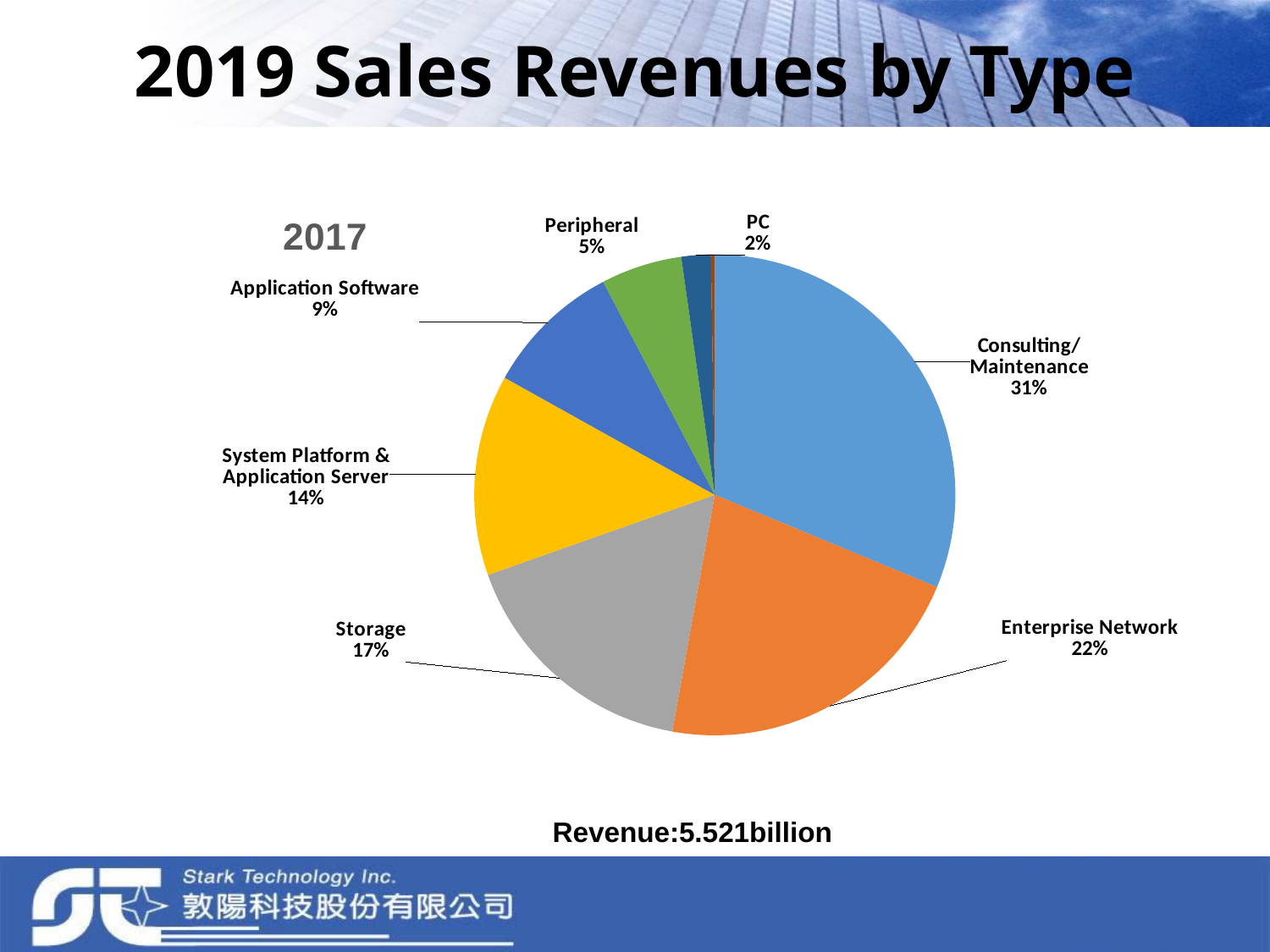
What percentage is shown for PC? 2% What percentage is shown for System Platform & Application Server? 14% What share of sales revenue does Consulting/Maintenance account for? 31% What percentage is shown for Enterprise Network? 22% Which has a larger share, Peripheral or Application Software? Application Software What percentage is shown for Storage? 17% Which category has the largest share of the pie? Consulting/Maintenance What kind of chart is shown on the slide? pie chart What is the difference in percentage points between Enterprise Network and Storage? 5 What percentage is shown for Application Software? 9%